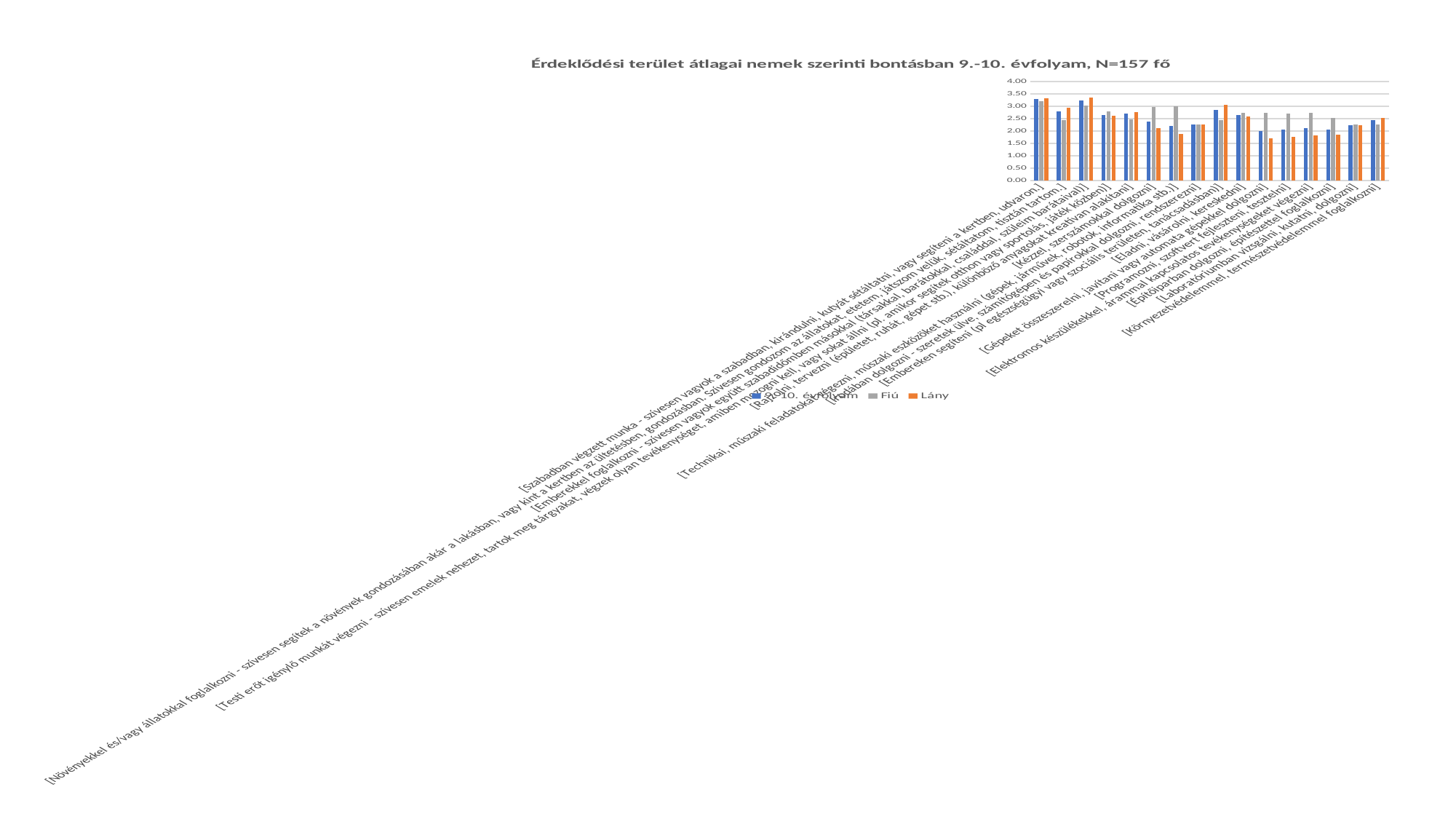
How many series does the legend list? 3 Is the Fiú value for the last category, [Környezetvédelemmel, természetvédelemmel foglalkozni], greater or less than 3.00? less What is the title of the chart? Érdeklődési terület átlagai nemek szerinti bontásban 9.-10. évfolyam, N=157 fő What is the highest value shown on the y axis? 4.00 Which legend entry is shown in orange? Lány What kind of chart is shown on the slide? bar chart How many categories (interest areas) are plotted on the x axis? 16 Is the Lány value for the last category, [Környezetvédelemmel, természetvédelemmel foglalkozni], greater or less than 2.00? greater Is the Lány value for [Emberekkel foglalkozni ...] greater or less than 3.00? greater